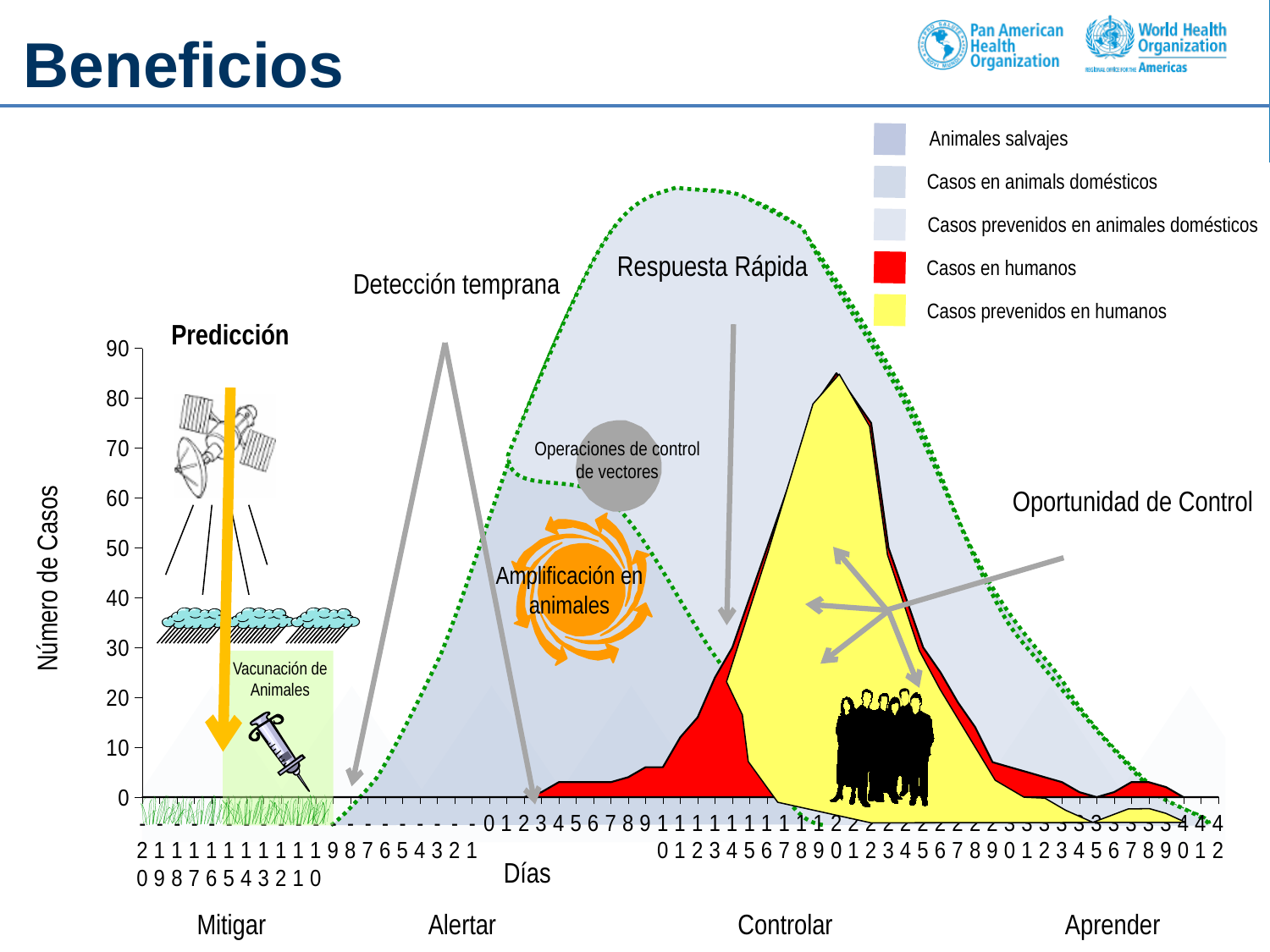
Is the peak of the 'Casos en humanos' (red) area greater or less than 40? less Which legend entry is shown in red? Casos en humanos How many series does the legend list? 5 What is the label of the vertical axis? Número de Casos What is the highest value shown on the vertical axis? 90 Is the peak of the 'Casos en animals domésticos' area greater or less than 90? greater How many phases are labelled along the bottom of the chart (Mitigar, Alertar, Controlar, Aprender)? 4 What kind of chart is shown on the slide? Area chart Does the 'Casos en humanos' area rise or fall between day 10 and day 13? rise Is the peak of the 'Casos prevenidos en humanos' (yellow) area greater or less than 80? greater Which is higher at its peak: the 'Casos prevenidos en humanos' area or the 'Casos en humanos' area? Casos prevenidos en humanos What is the label of the horizontal axis? Días